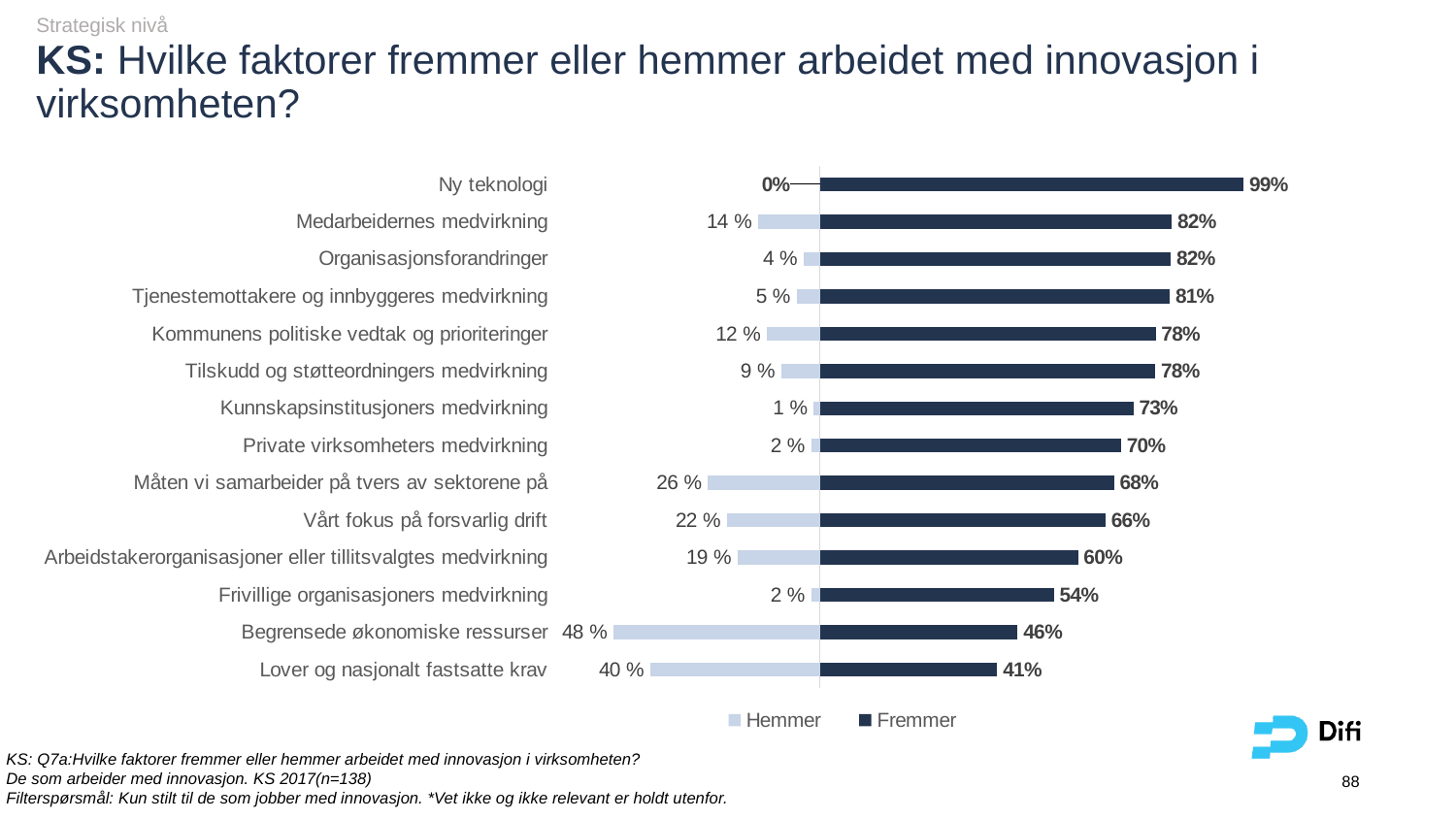
Which category has the lowest Fremmer value? Lover og nasjonalt fastsatte krav How many series does the legend list? 2 Which category has the highest Fremmer value? Ny teknologi Which category has the highest Hemmer value? Begrensede økonomiske ressurser What is the Hemmer value for Begrensede økonomiske ressurser? 48 % What is the Hemmer value for Måten vi samarbeider på tvers av sektorene på? 26 % What is the difference between the Fremmer values for Ny teknologi and Lover og nasjonalt fastsatte krav? 58 percentage points How many categories are shown in the chart? 14 Which is larger for Begrensede økonomiske ressurser, the Hemmer value or the Fremmer value? Hemmer What kind of chart is shown on the slide? Bar chart What is the Fremmer value for Ny teknologi? 99% What is the Fremmer value for Vårt fokus på forsvarlig drift? 66%